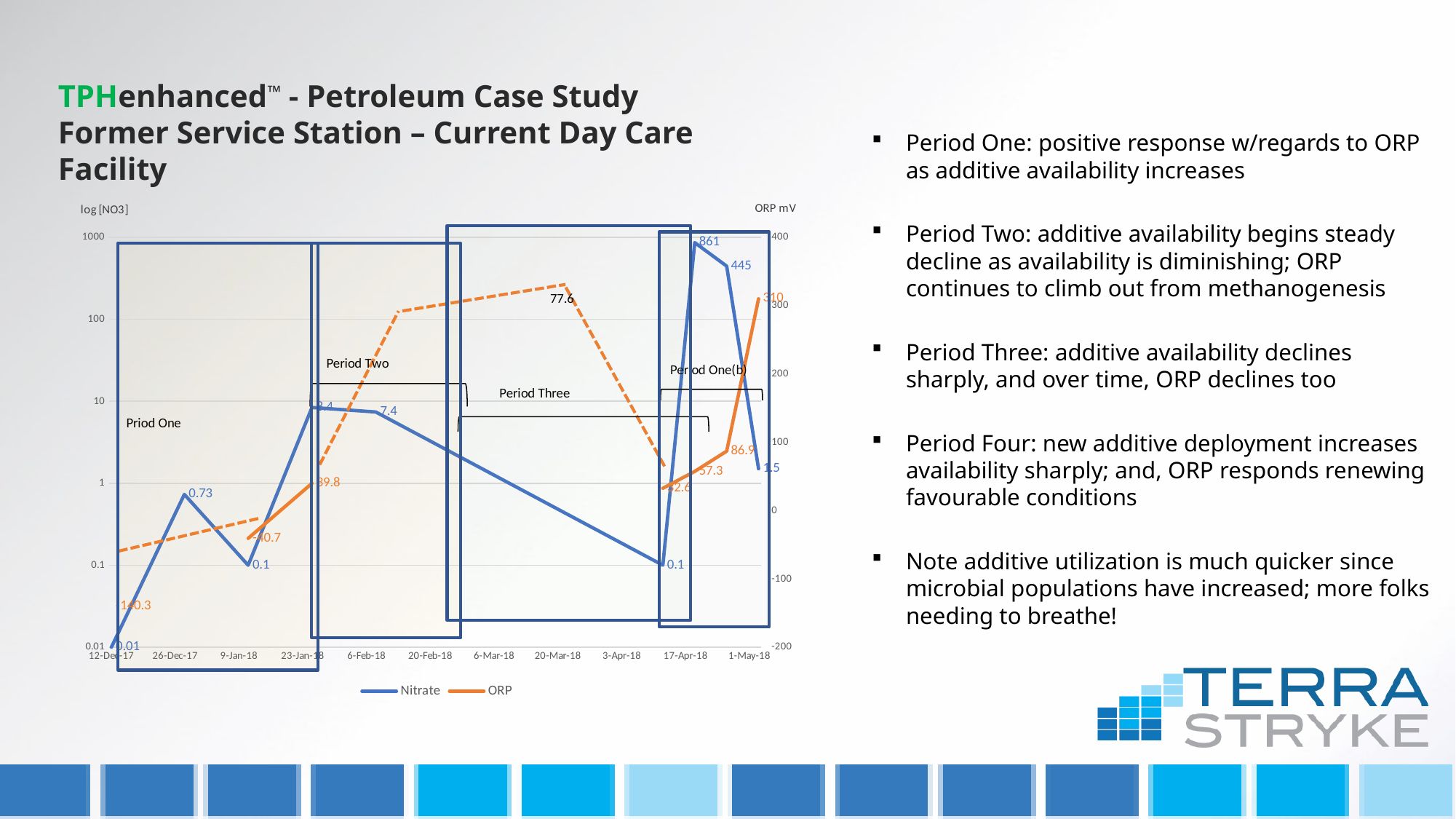
How many series does the chart legend list? 2 Which is larger, the Nitrate value labelled 861 or the one labelled 445? 861 Is the Nitrate value at 9-Jan-18 greater or less than 1? less What is the highest labelled Nitrate value on the chart? 861 What is the Nitrate value labelled at 6-Feb-18? 7.4 What kind of chart is shown on the slide? line chart What is the difference between the Nitrate values labelled 861 and 445? 416 What are the two series named in the chart legend? Nitrate and ORP What is the highest labelled ORP value on the chart? 310 What is the Nitrate value labelled at 26-Dec-17? 0.73 What is the title of the right-hand vertical axis? ORP mV